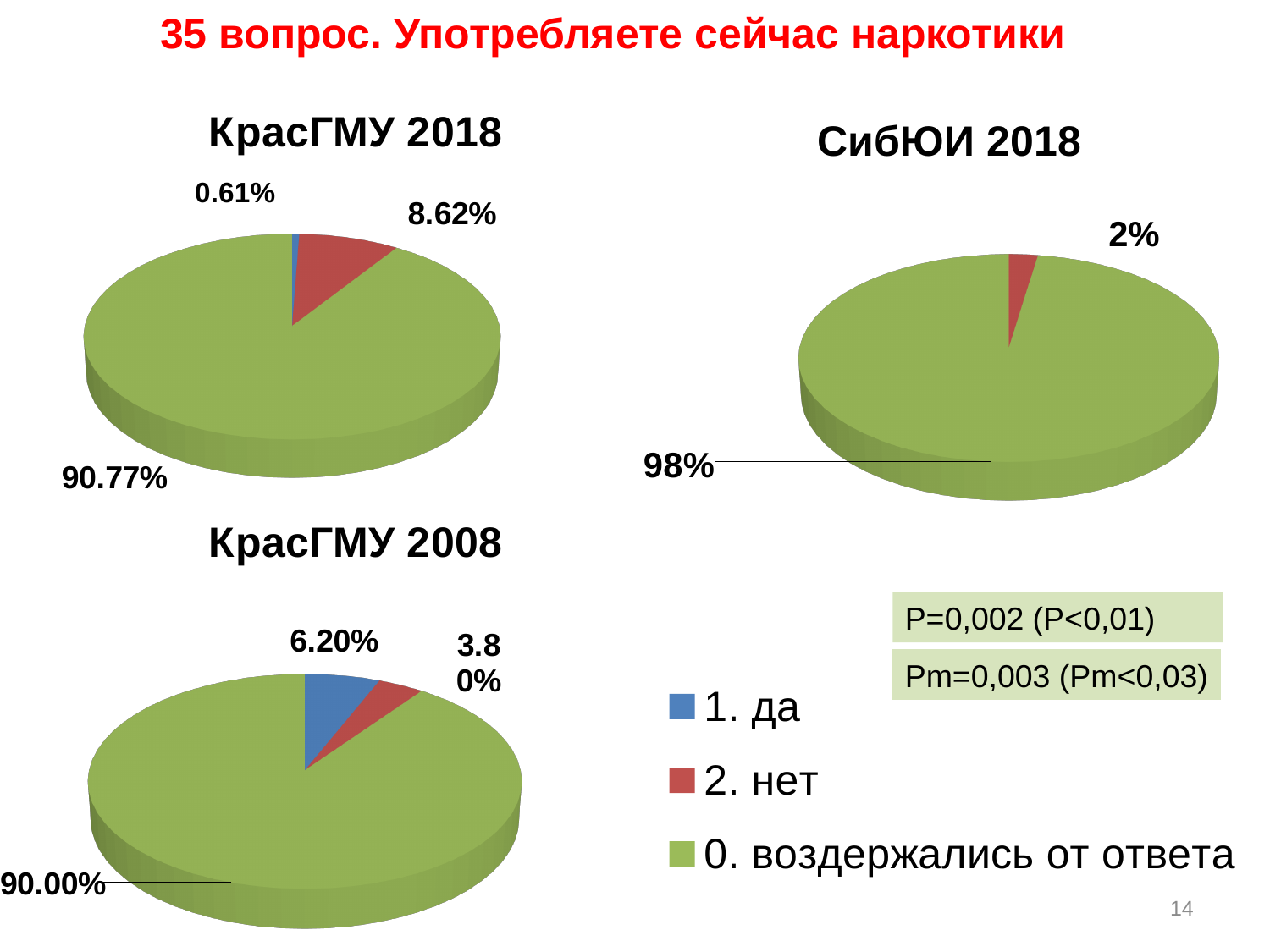
In the КрасГМУ 2008 chart, which is larger: the "1. да" slice or the "2. нет" slice? 1. да In the КрасГМУ 2008 chart, what share of respondents chose "0. воздержались от ответа"? 90.00% In the СибЮИ 2018 chart, what share of respondents chose "0. воздержались от ответа"? 98% How many entries does the legend on the slide list? 3 In the СибЮИ 2018 chart, what share of respondents answered "2. нет"? 2% In the КрасГМУ 2018 chart, what share of respondents chose "0. воздержались от ответа"? 90.77% In the КрасГМУ 2018 chart, what share of respondents answered "1. да"? 0.61% In the КрасГМУ 2018 chart, which category has the smallest slice? 1. да In the КрасГМУ 2018 chart, what share of respondents answered "2. нет"? 8.62% In the КрасГМУ 2008 chart, what share of respondents answered "1. да"? 6.20% What type of chart is the СибЮИ 2018 chart? pie chart In the КрасГМУ 2018 chart, which category has the largest slice? 0. воздержались от ответа